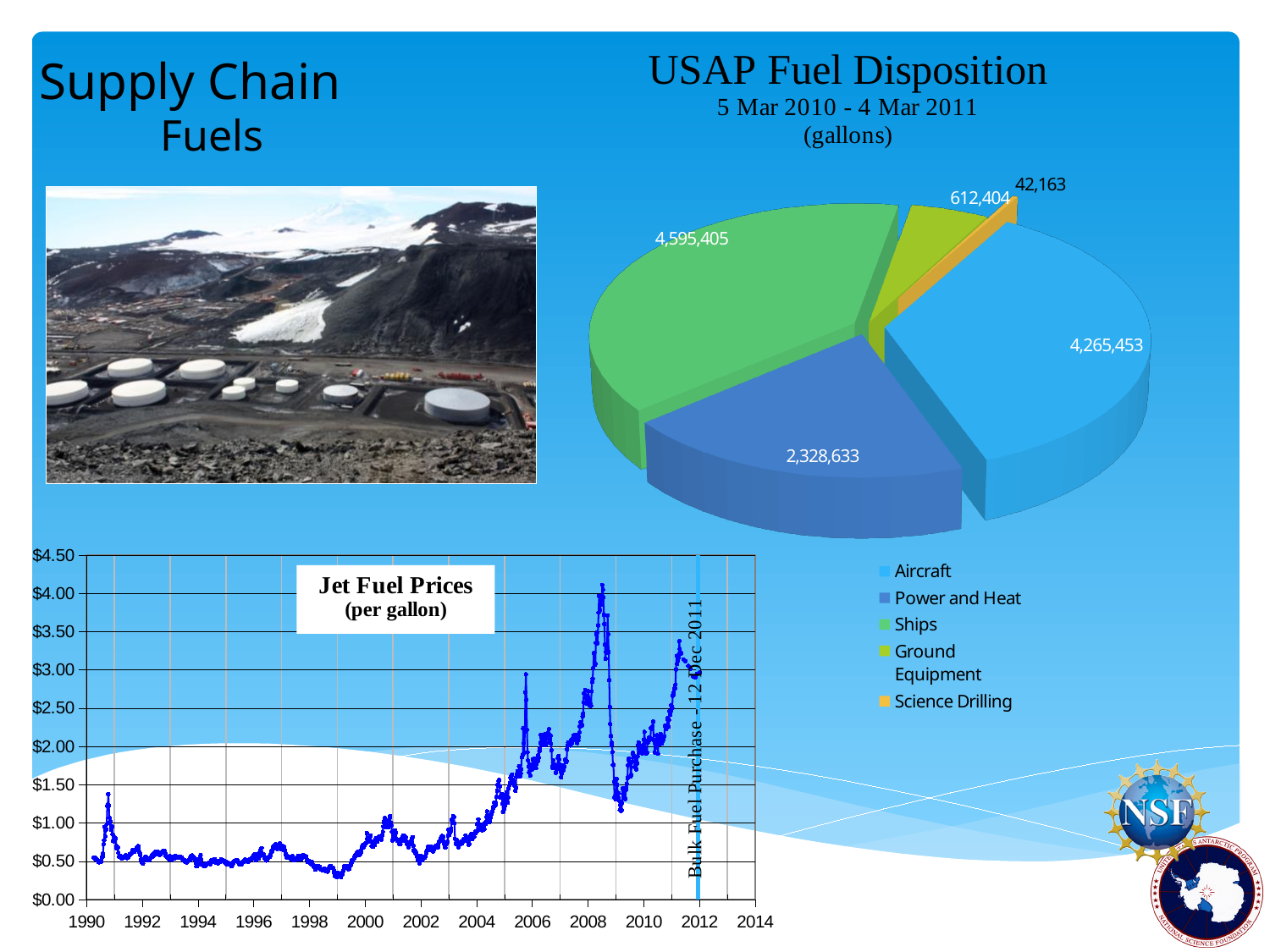
In the USAP Fuel Disposition pie chart, how many gallons went to Power and Heat? 2,328,633 In the USAP Fuel Disposition pie chart, how many gallons went to Science Drilling? 42,163 In the USAP Fuel Disposition pie chart, how many gallons went to Aircraft? 4,265,453 What kind of chart is the Jet Fuel Prices chart at the bottom left of the slide? Line chart In the Jet Fuel Prices chart, is the price in 1998 greater or less than $1.00? less In the USAP Fuel Disposition pie chart, which category used the least fuel? Science Drilling In the USAP Fuel Disposition pie chart, which is larger: Ground Equipment or Power and Heat? Power and Heat How many categories does the legend of the USAP Fuel Disposition pie chart list? 5 In the Jet Fuel Prices chart, is the price at the end of 2011 greater or less than $2.50? greater In the USAP Fuel Disposition pie chart, what is the difference in gallons between Ships and Aircraft? 329,952 In the USAP Fuel Disposition pie chart, which category used the most fuel? Ships In the Jet Fuel Prices chart, do prices overall rise or fall from 1990 to 2012? Rise